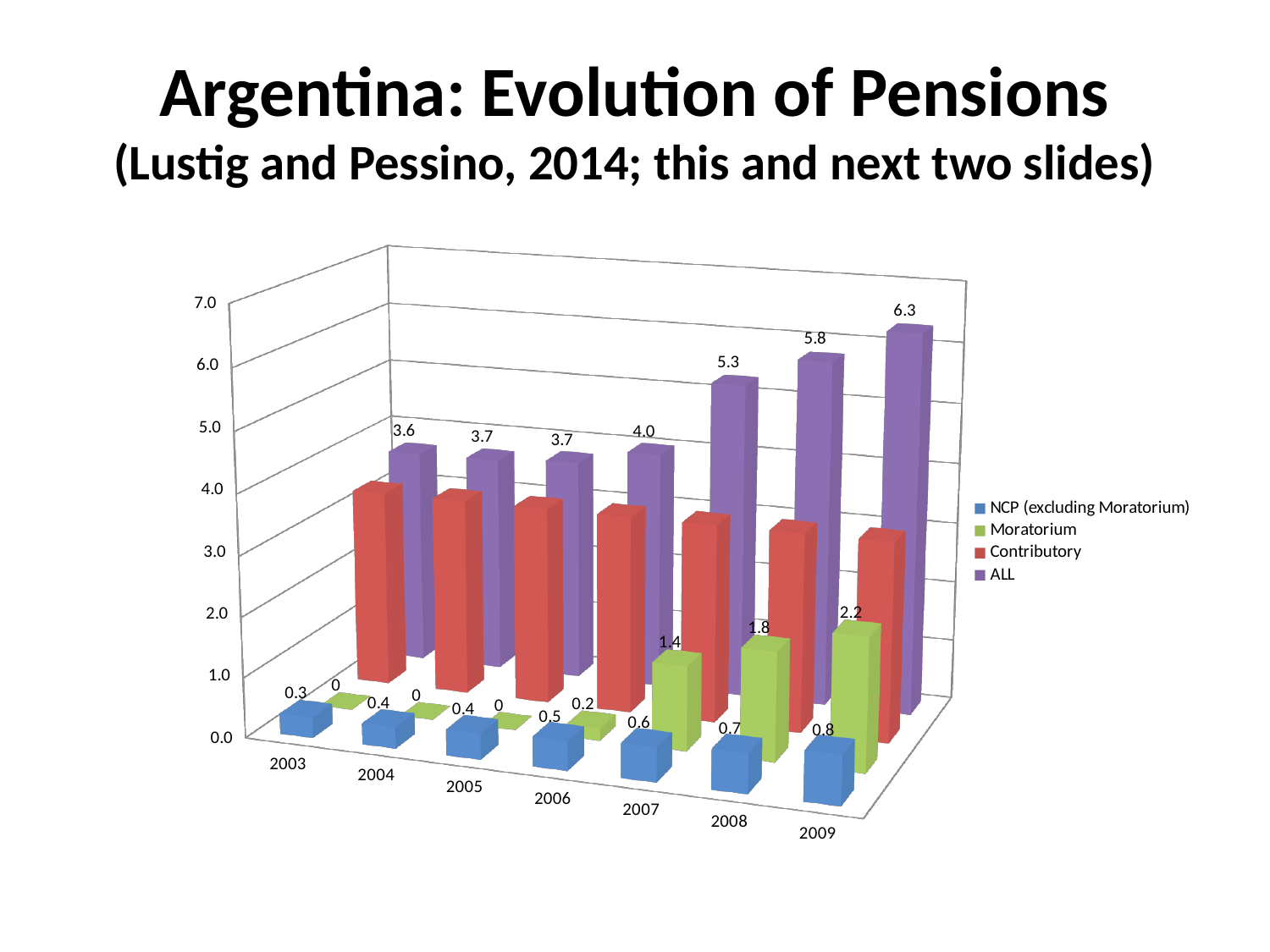
Is the Contributory value for 2003 greater or less than 2.0? greater Does the ALL series rise or fall from 2003 to 2009? rise What is the value for ALL in 2009? 6.3 What is the value for Moratorium in 2007? 1.4 What is the value for NCP (excluding Moratorium) in 2003? 0.3 How many series does the legend list? 4 In which year is the NCP (excluding Moratorium) series lowest? 2003 What is the difference between the ALL value in 2009 and the ALL value in 2003? 2.7 What kind of chart is shown on the slide? bar chart In which year is the ALL series highest? 2009 Which is larger, the Moratorium value in 2008 or the NCP (excluding Moratorium) value in 2008? Moratorium How many years are shown on the x axis? 7